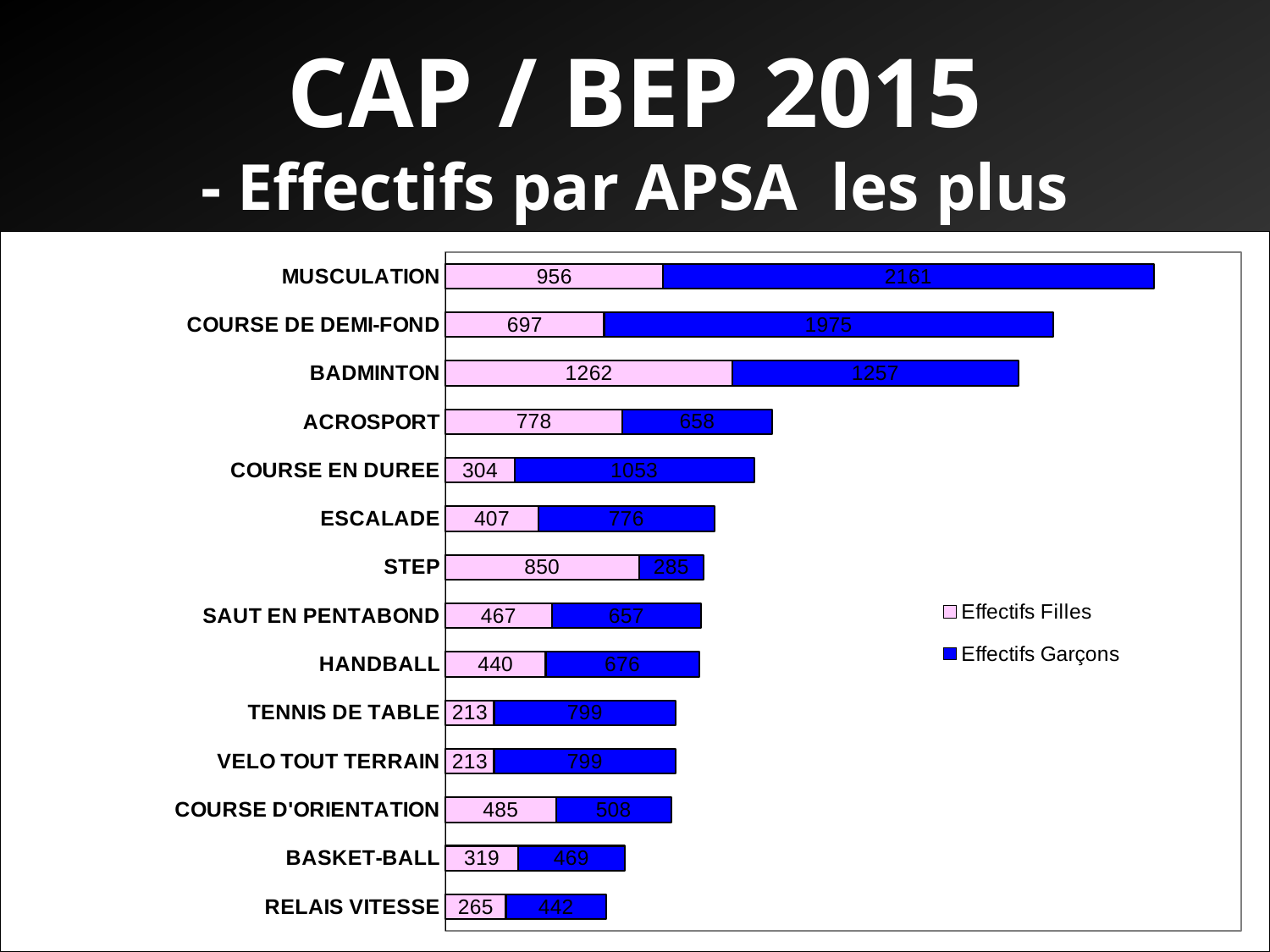
What is the value of Effectifs Filles for STEP? 850 How many series does the legend list? 2 Which colour represents Effectifs Garçons in the chart? Blue What is the value of Effectifs Garçons for MUSCULATION? 2161 Which is larger for ACROSPORT: Effectifs Filles or Effectifs Garçons? Effectifs Filles What is the total of the stacked bar for ESCALADE? 1183 What is the value of Effectifs Filles for BADMINTON? 1262 What is the difference between Effectifs Garçons and Effectifs Filles for COURSE DE DEMI-FOND? 1278 How many categories are shown on the chart? 14 Which category has the lowest value for Effectifs Filles? TENNIS DE TABLE and VELO TOUT TERRAIN (213) What kind of chart is shown on the slide? Stacked bar chart Which category has the highest value for Effectifs Garçons? MUSCULATION